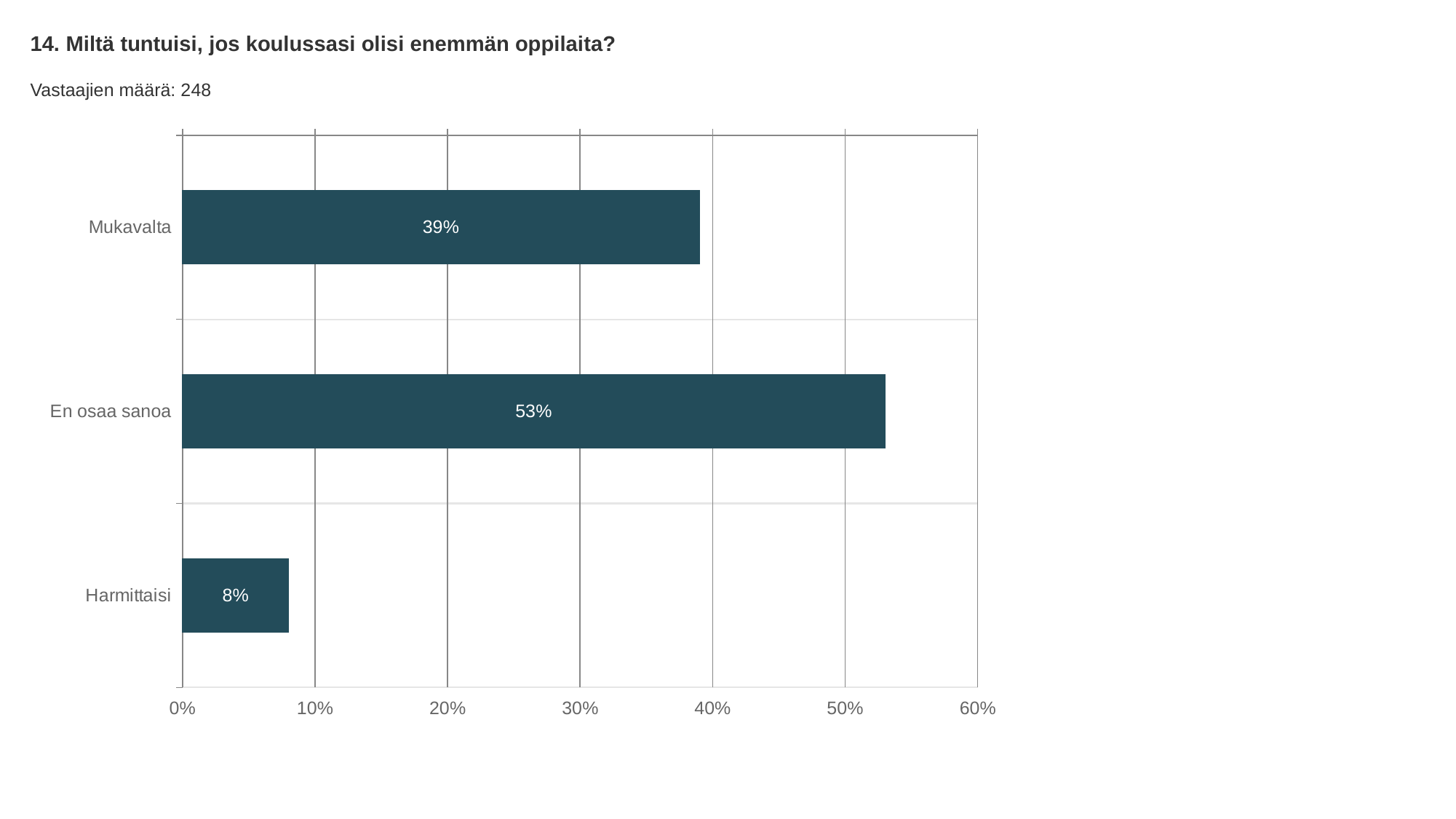
What kind of chart is shown on the slide? bar chart Which category has the lowest value? Harmittaisi What is the difference between the values for En osaa sanoa and Mukavalta? 14% How many respondents (Vastaajien määrä) are reported on the slide? 248 What is the difference between the values for Mukavalta and Harmittaisi? 31% Which is larger, the value for Mukavalta or the value for Harmittaisi? Mukavalta What is the value for En osaa sanoa? 53% Which category has the highest value? En osaa sanoa How many categories are shown in the chart? 3 What is the value for Harmittaisi? 8% What is the value for Mukavalta? 39% Is the value for En osaa sanoa greater or less than 50%? greater